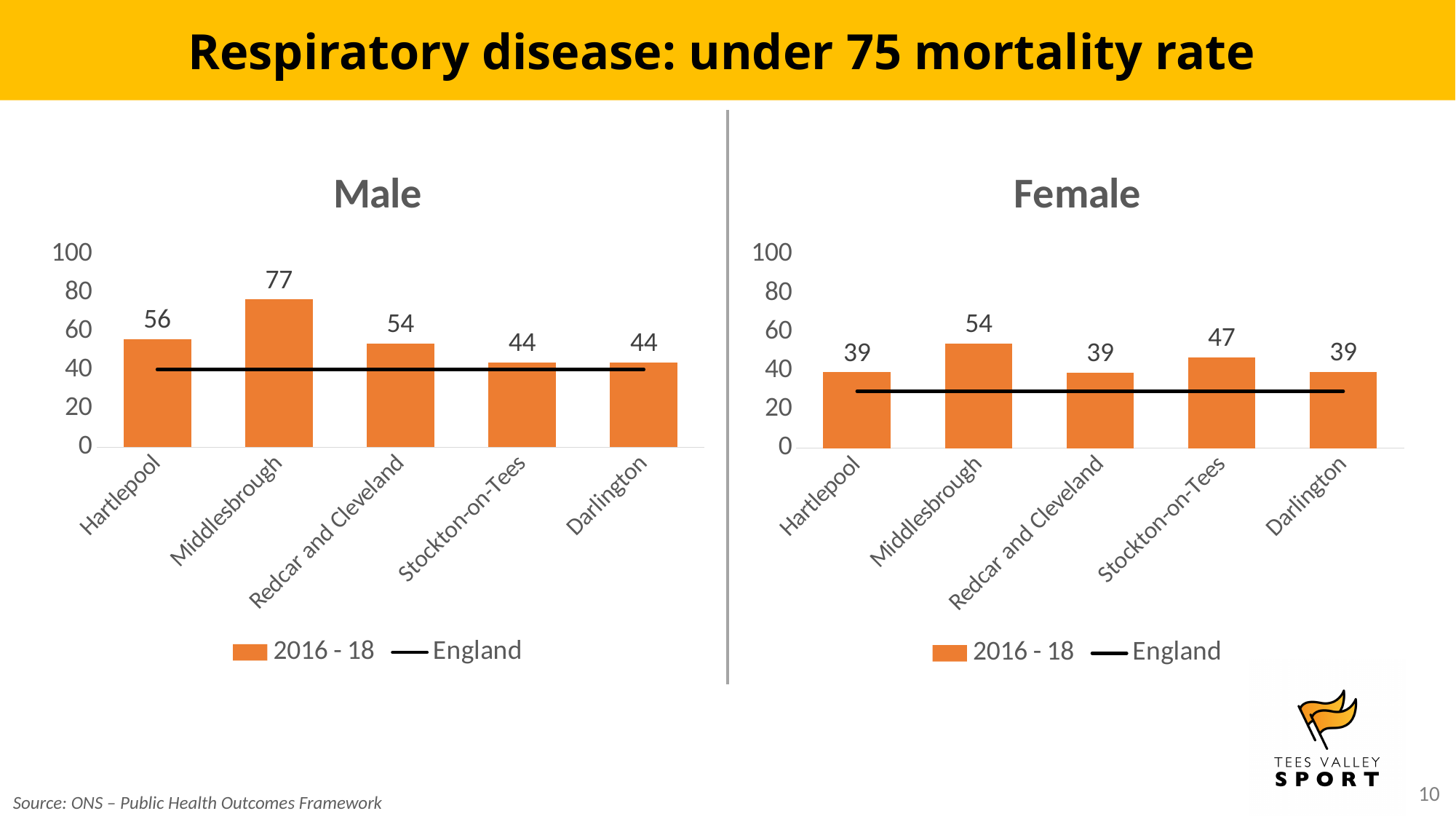
In the Female chart, is the England line greater or less than 40? less How many series does the legend of the Male chart list? 2 In the Male chart, what is the difference between Middlesbrough and Hartlepool? 21 In the Male chart, which area has the highest value? Middlesbrough In the Male chart, what is the value for Middlesbrough? 77 In the Female chart, which area has the highest value? Middlesbrough How many areas are shown in the Female chart? 5 In the Female chart, what is the difference between Middlesbrough and Darlington? 15 In the Male chart, is the England line greater or less than 60? less What kind of chart is the Male chart? combination bar and line chart In the Female chart, what is the value for Stockton-on-Tees? 47 In the Male chart, which is larger, Hartlepool or Redcar and Cleveland? Hartlepool